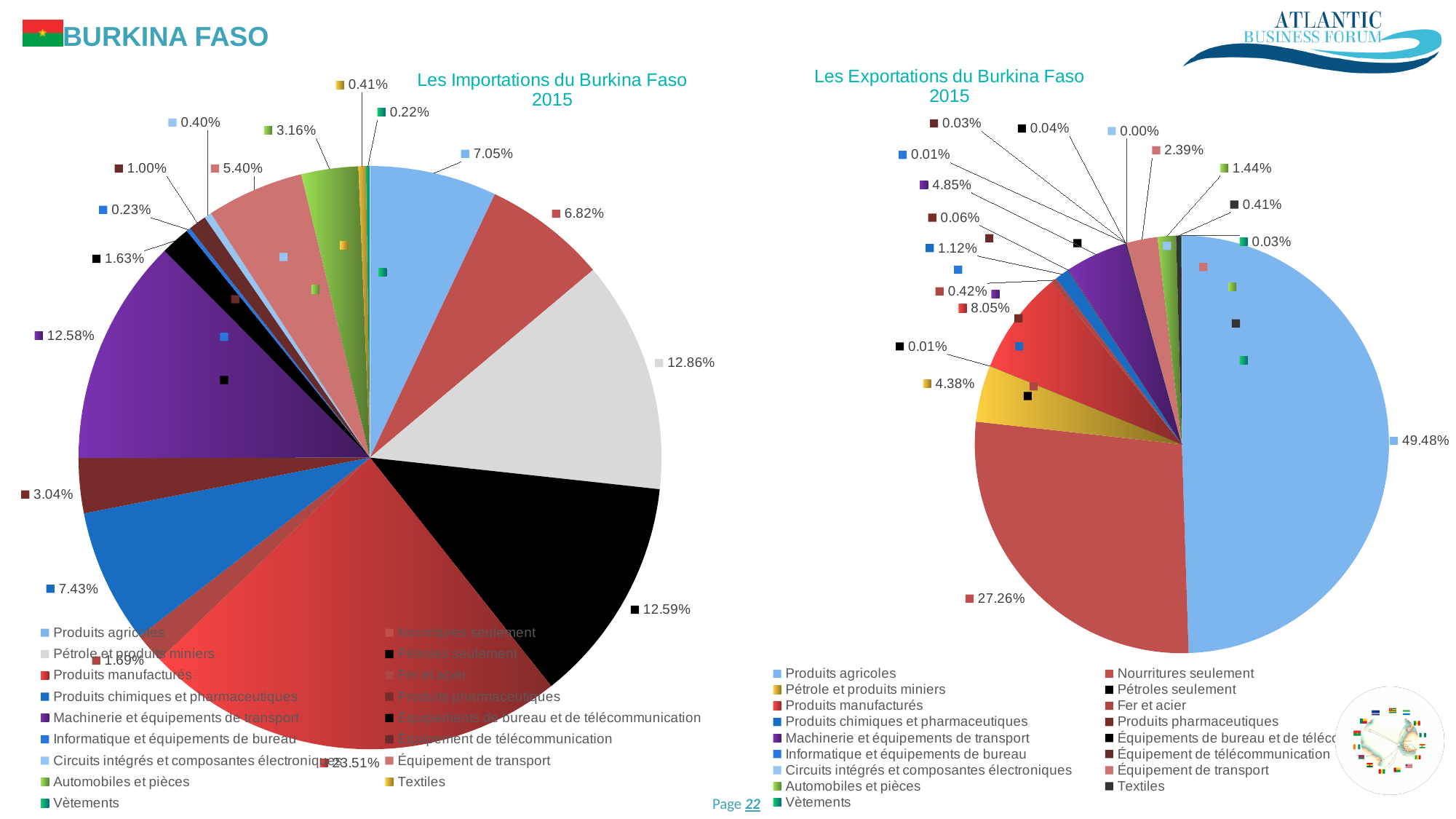
In the 'Les Importations du Burkina Faso 2015' chart, what is the share of Automobiles et pièces? 3.16% In the 'Les Exportations du Burkina Faso 2015' chart, what is the difference between Produits agricoles and Nourritures seulement? 22.22% In the 'Les Importations du Burkina Faso 2015' chart, what is the share of Pétrole et produits miniers? 12.86% In the 'Les Importations du Burkina Faso 2015' chart, which is larger: Machinerie et équipements de transport or Produits chimiques et pharmaceutiques? Machinerie et équipements de transport In the 'Les Importations du Burkina Faso 2015' chart, what is the difference between Produits manufacturés and Pétrole et produits miniers? 10.65% In the 'Les Exportations du Burkina Faso 2015' chart, what is the share of Produits agricoles? 49.48% What kind of chart is used for 'Les Importations du Burkina Faso 2015'? Pie chart In the 'Les Exportations du Burkina Faso 2015' chart, which category has the largest slice? Produits agricoles In the 'Les Importations du Burkina Faso 2015' chart, what share do Produits agricoles have? 7.05% How many categories does the legend of the 'Les Exportations du Burkina Faso 2015' chart list? 17 In the 'Les Exportations du Burkina Faso 2015' chart, what is the share of Nourritures seulement? 27.26% In the 'Les Importations du Burkina Faso 2015' chart, what is the value of the largest slice? 23.51%